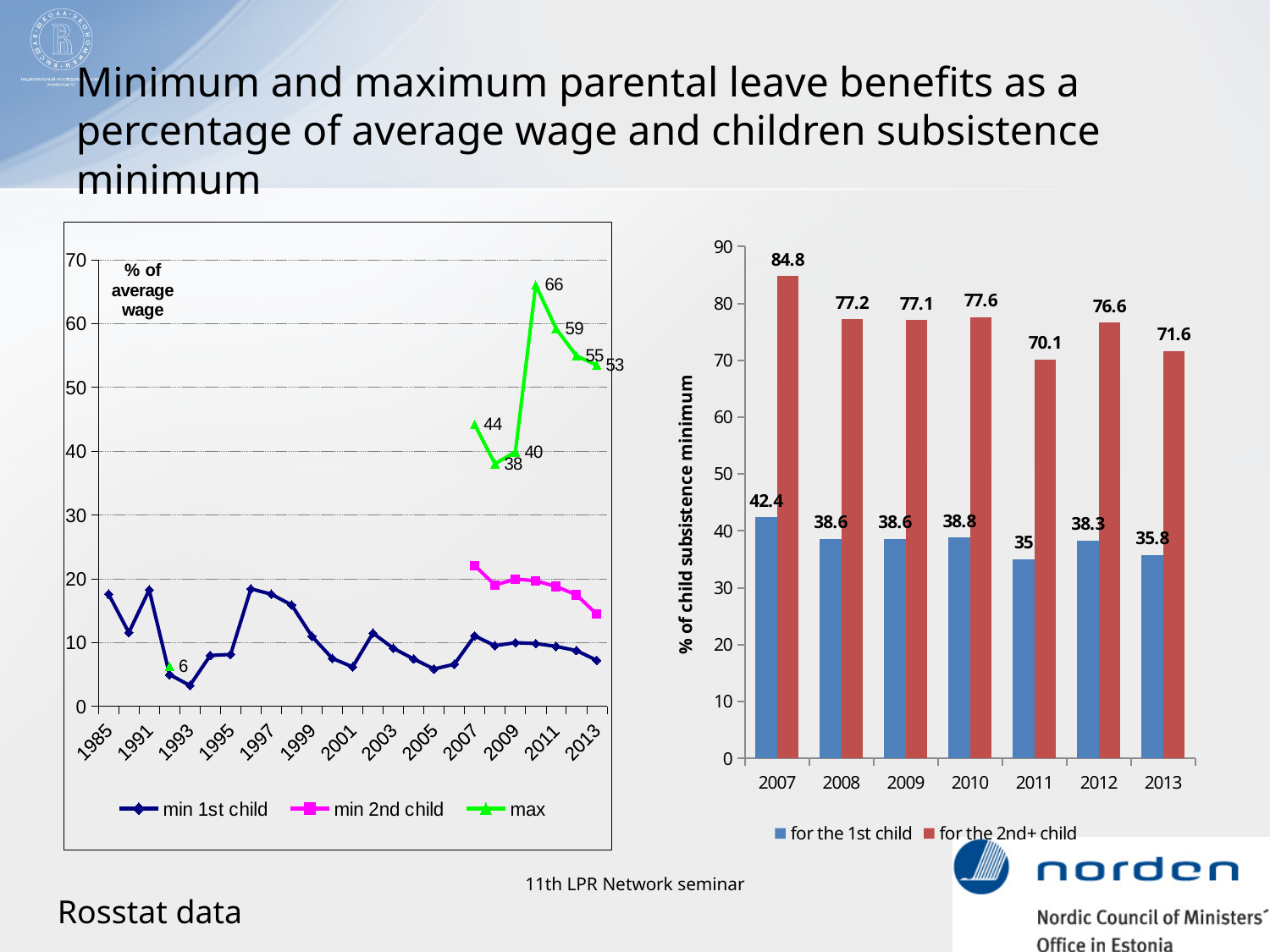
In the right-hand bar chart, which year has the highest value for the 2nd+ child? 2007 In the left-hand line chart, is the value of the max series in 2013 greater or less than 50? greater In the right-hand bar chart, what is the value for the 1st child in 2011? 35 In the right-hand bar chart, what is the value for the 2nd+ child in 2007? 84.8 How many series does the legend of the left-hand line chart list? 3 In the right-hand bar chart, is the 2nd+ child value larger in 2010 or in 2012? 2010 In the left-hand line chart, what is the value of the max series in 2010? 66 What kind of chart is the left-hand chart? line chart In the right-hand bar chart, what is the difference between the 2nd+ child and 1st child values in 2013? 35.8 In the right-hand bar chart, which year has the lowest value for the 1st child? 2011 How many series does the legend of the right-hand bar chart list? 2 How many years are shown on the x axis of the right-hand bar chart? 7